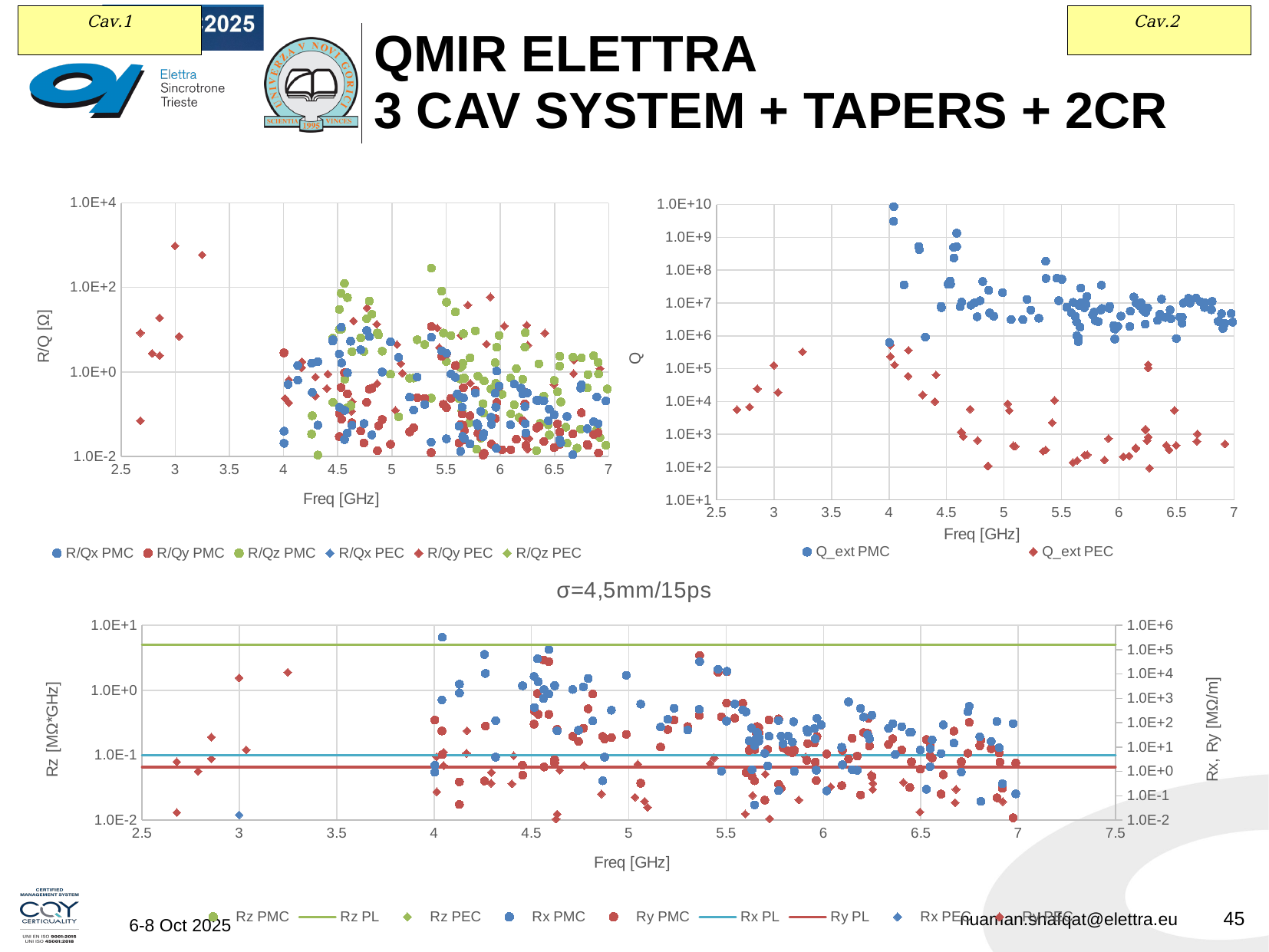
In the top-right Q chart, do the Q_ext PMC values generally rise or fall as frequency increases from 4 GHz to 7 GHz? fall How many charts are shown on the slide? 3 What kind of chart is the top-left chart with y-axis R/Q [Ω]? scatter chart In the top-right Q chart, is the highest Q_ext PMC value greater or less than 1.0E+9? greater In the bottom chart, is the Rz PL line greater or less than 1.0E+0 on the left axis? greater In the top-left R/Q chart, which series contains the highest plotted point? R/Qy PEC In the top-right Q chart, are the Q_ext PEC values near 6.5 GHz greater or less than 1.0E+4? less How many series does the legend of the top-right Q chart list? 2 How many series does the legend of the top-left R/Q chart list? 6 What is the title of the bottom chart? σ=4,5mm/15ps In the top-right Q chart, which series has the higher values overall, Q_ext PMC or Q_ext PEC? Q_ext PMC What is the x-axis label of the top-right Q chart? Freq [GHz]